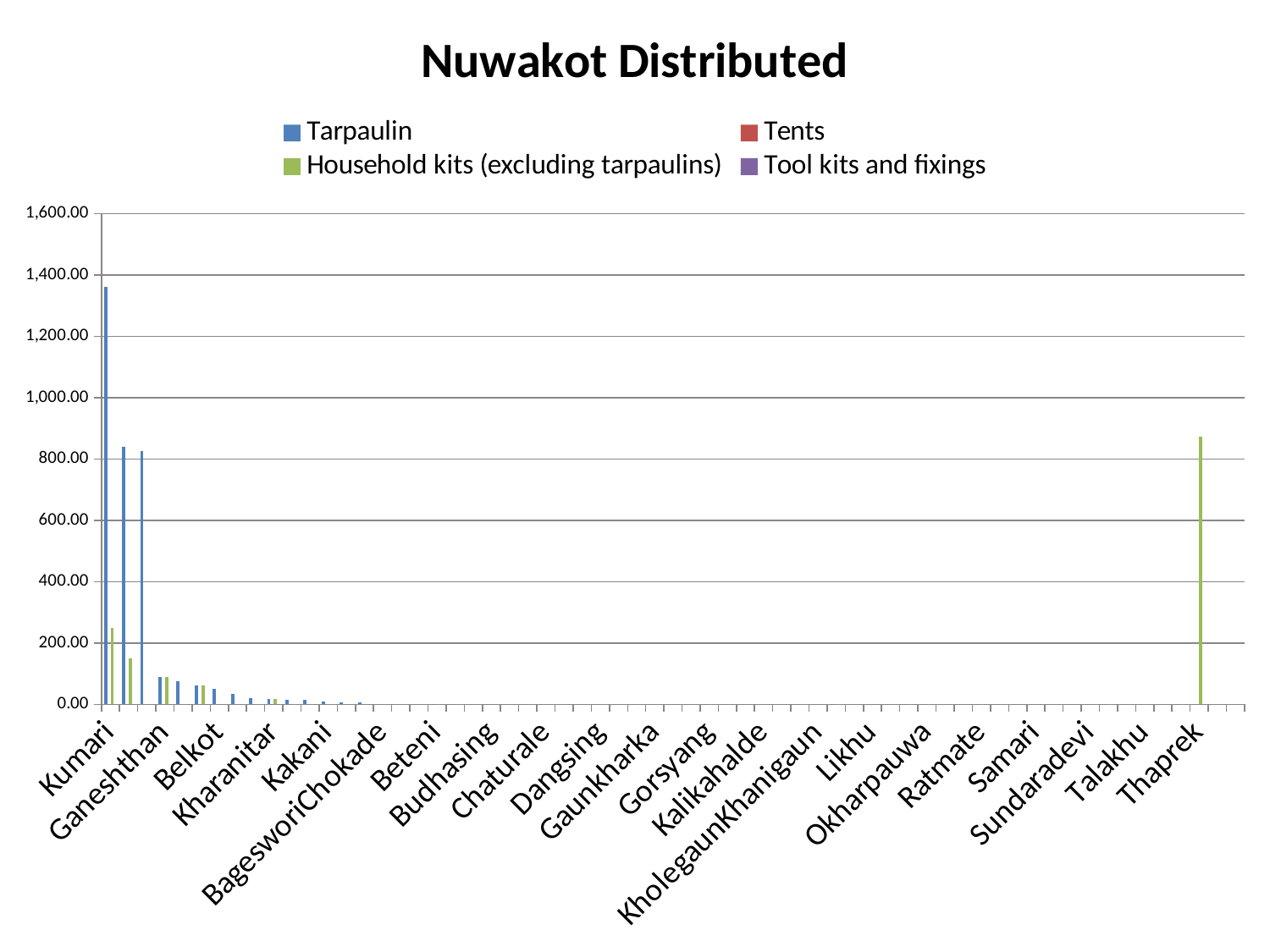
Which series is shown in green in the legend? Household kits (excluding tarpaulins) Is the Tarpaulin value for Kumari greater or less than 1,200? greater Which category has the highest Household kits (excluding tarpaulins) value? Thaprek Which is larger: the Tarpaulin value for Kumari or the Tarpaulin value for Belkot? Tarpaulin value for Kumari Is the Tarpaulin value for Ganeshthan greater or less than 200? less How many series does the legend list? 4 Which is larger: the Tarpaulin value for Kumari or the Household kits (excluding tarpaulins) value for Thaprek? Tarpaulin value for Kumari Is the Household kits (excluding tarpaulins) value for Thaprek greater or less than 800? greater What kind of chart is shown on the slide? bar chart Which category has the highest Tarpaulin value? Kumari What is the title of the chart? Nuwakot Distributed